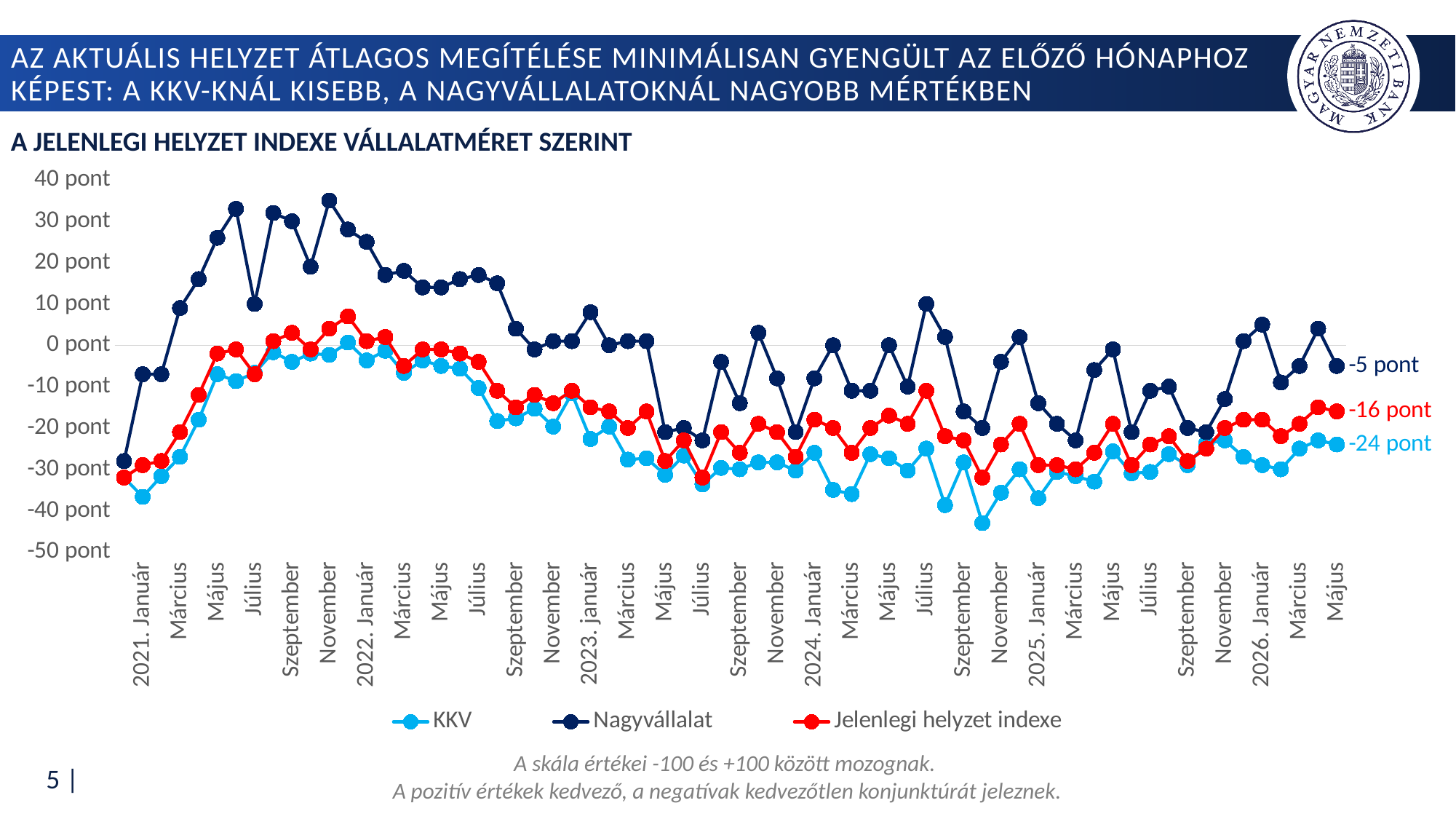
How many series does the legend list? 3 Does the Nagyvállalat series rise or fall between 2021 Január and 2021 Május? rise What is the value of the Jelenlegi helyzet indexe series at the last point (2026 Május)? -16 pont What is the title of the chart? A JELENLEGI HELYZET INDEXE VÁLLALATMÉRET SZERINT At the last point (2026 Május), what is the difference between the Nagyvállalat value and the KKV value? 19 pont What kind of chart is shown on the slide? line chart What is the value of the KKV series at the last point (2026 Május)? -24 pont Which series has the highest value at the last point (2026 Május)? Nagyvállalat What is the value of the Nagyvállalat series at the last point (2026 Május)? -5 pont Is the Nagyvállalat value for 2021 November greater or less than 30 pont? greater At the last point (2026 Május), which series has the higher value, KKV or Nagyvállalat? Nagyvállalat Is the Jelenlegi helyzet indexe value for 2021 Január greater or less than -20 pont? less